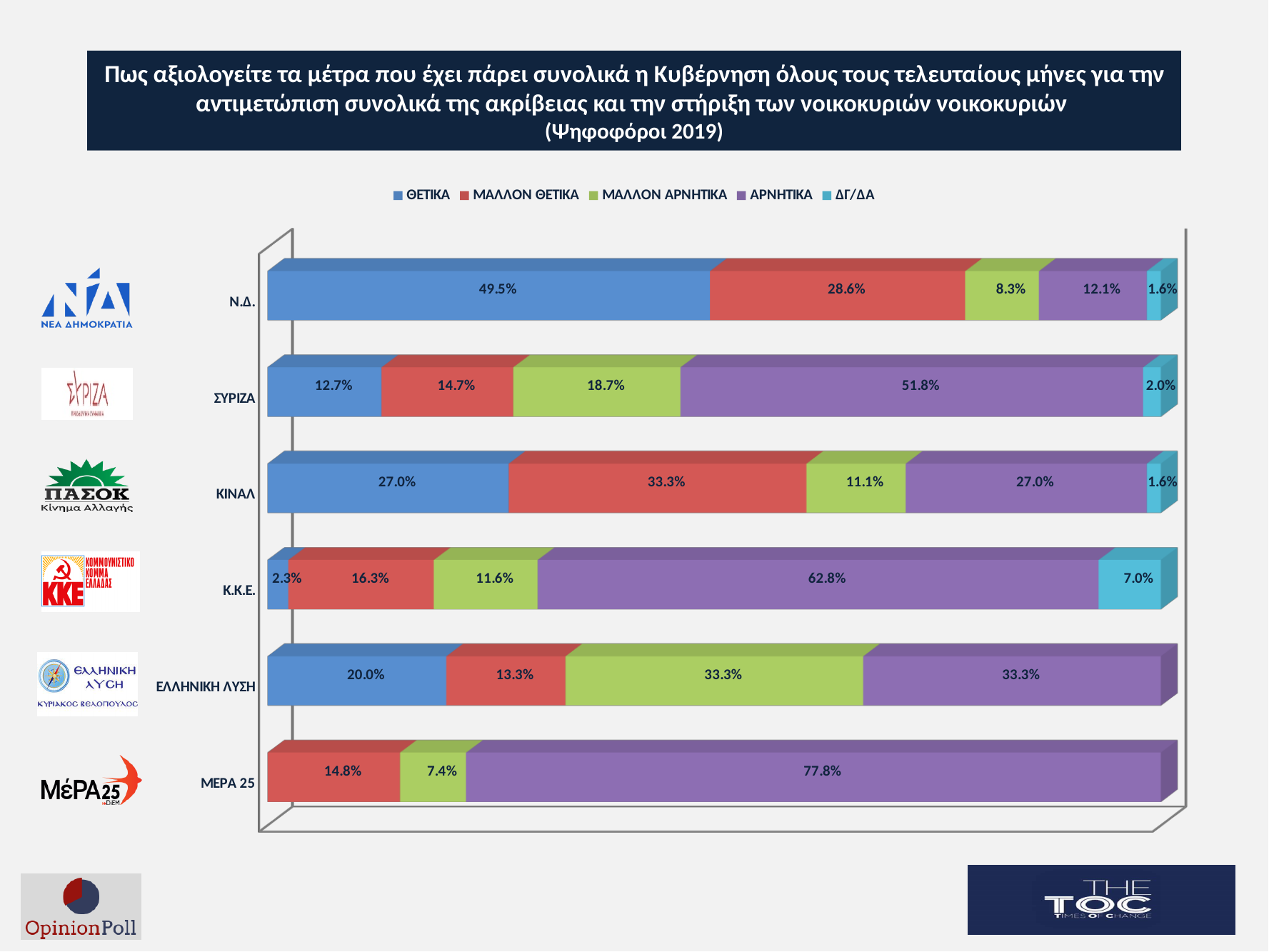
Which is larger: the ΜΑΛΛΟΝ ΘΕΤΙΚΑ value for ΚΙΝΑΛ or for ΣΥΡΙΖΑ? ΚΙΝΑΛ How many series does the legend list? 5 What is the difference between the ΘΕΤΙΚΑ values for Ν.Δ. and ΚΙΝΑΛ? 22.5% What is the ΜΑΛΛΟΝ ΑΡΝΗΤΙΚΑ value for ΕΛΛΗΝΙΚΗ ΛΥΣΗ? 33.3% What is the ΑΡΝΗΤΙΚΑ value for ΣΥΡΙΖΑ? 51.8% Which legend entry is shown in purple? ΑΡΝΗΤΙΚΑ How many party categories are plotted on the chart? 6 What is the ΔΓ/ΔΑ value for Κ.Κ.Ε.? 7.0% What kind of chart is shown on the slide? Stacked bar chart Which party has the lowest ΘΕΤΙΚΑ value among those with a ΘΕΤΙΚΑ label? Κ.Κ.Ε. Which party has the highest ΑΡΝΗΤΙΚΑ value? ΜΕΡΑ 25 What is the ΘΕΤΙΚΑ value for Ν.Δ.? 49.5%